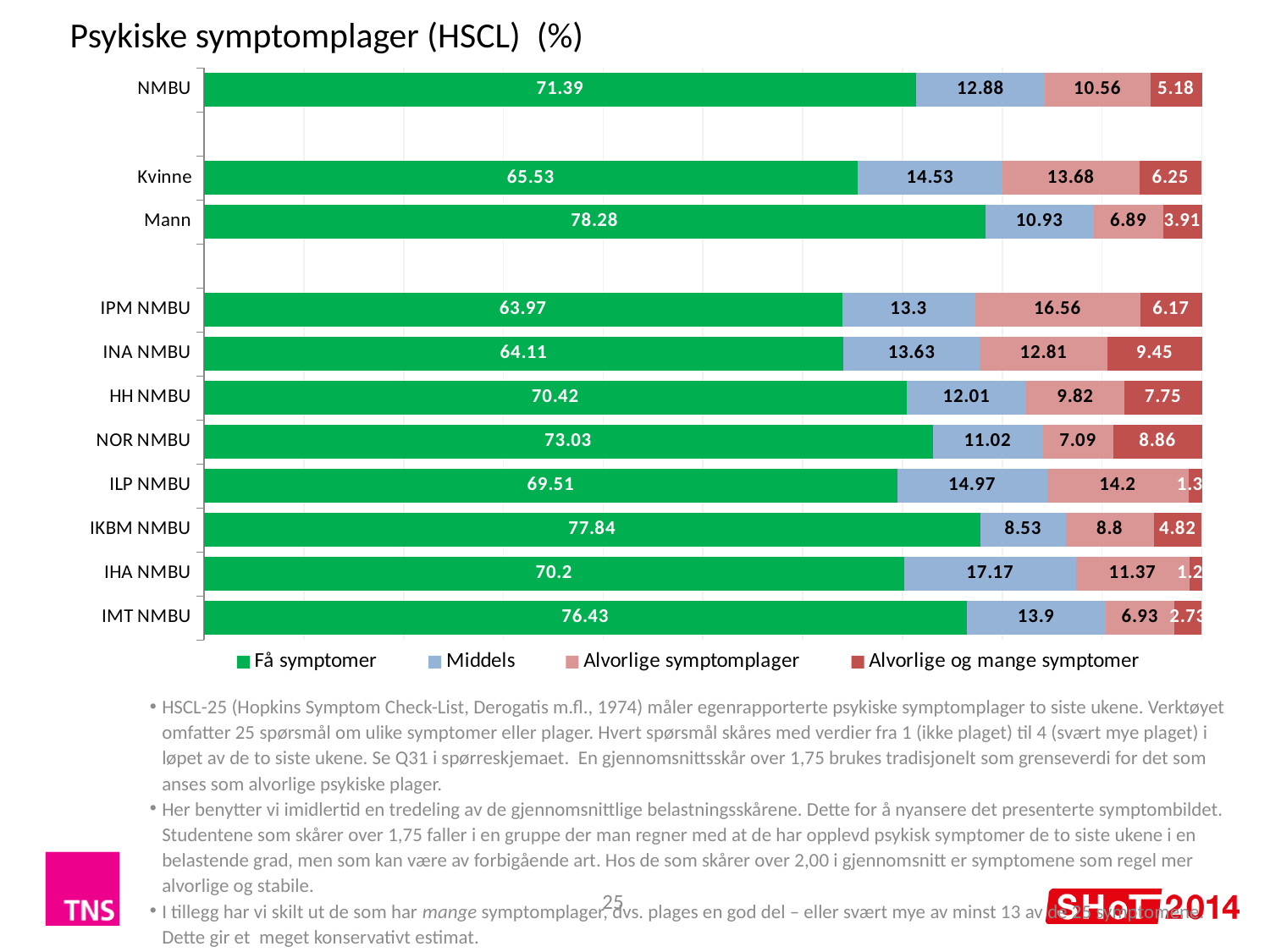
What type of chart is shown on the slide? Stacked bar chart Which category has the highest value for 'Få symptomer'? Mann Which category has the lowest value for 'Få symptomer'? IPM NMBU What is the value of 'Få symptomer' for Kvinne? 65.53 What is the value of 'Middels' for IHA NMBU? 17.17 How many categories are plotted on the chart? 11 What is the title of the chart? Psykiske symptomplager (HSCL) (%) What is the value of 'Alvorlige og mange symptomer' for NMBU? 5.18 What is the difference in 'Få symptomer' between Mann and Kvinne? 12.75 Which category has the highest value for 'Alvorlige og mange symptomer'? INA NMBU How many series does the legend list? 4 Which has the larger value for 'Alvorlige symptomplager', IPM NMBU or NOR NMBU? IPM NMBU